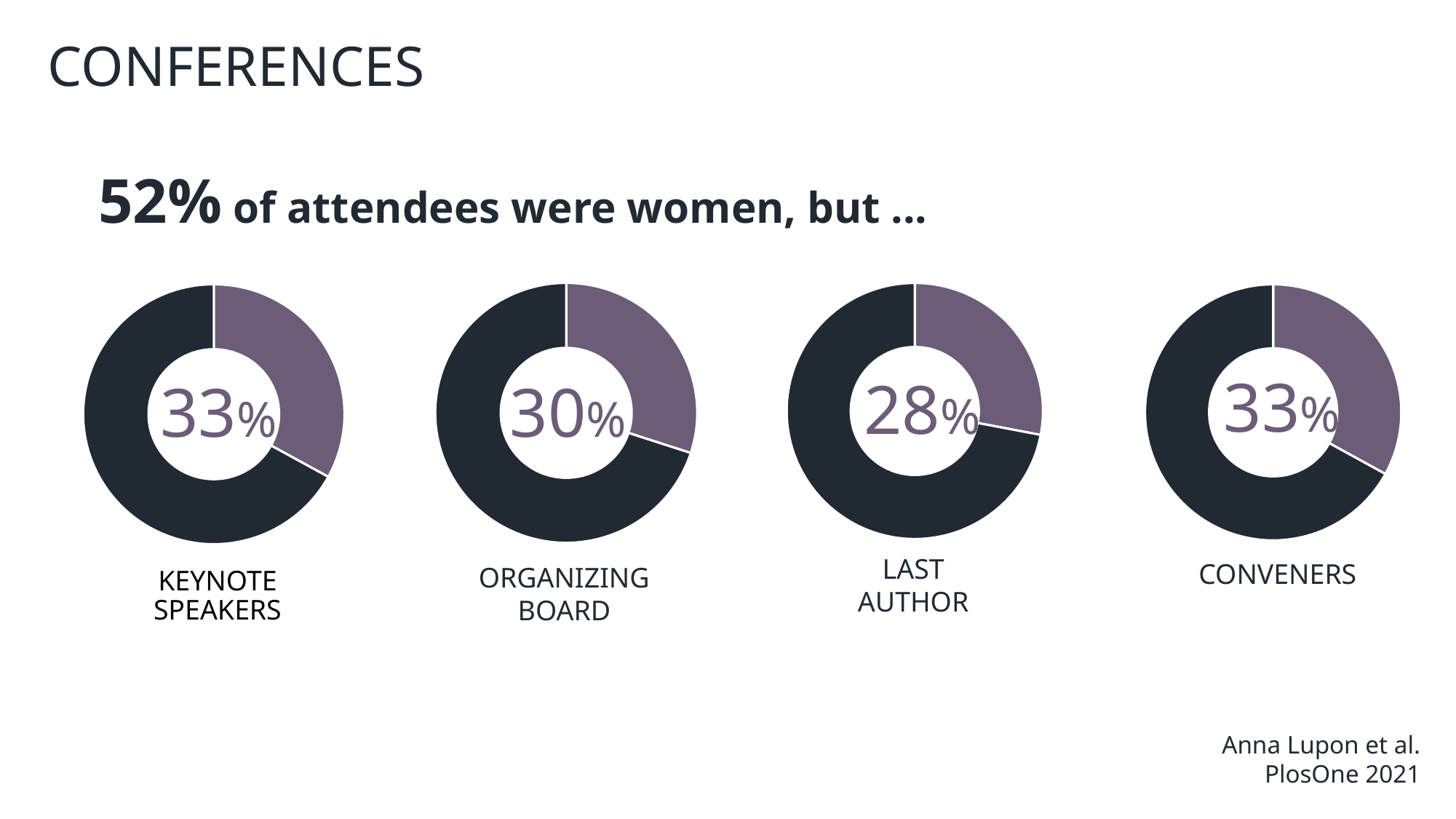
Which is larger, the percentage in the Keynote Speakers chart or the percentage in the Last Author chart? Keynote Speakers What kind of chart is used for the Keynote Speakers figure? Donut (pie) chart What is the difference between the percentage in the Organizing Board chart and the percentage in the Last Author chart? 2% In the Last Author chart, what percentage is shown in the centre? 28% In the Conveners chart, what percentage is shown in the centre? 33% How many donut charts are shown on the slide? 4 In the Last Author chart, what colour is the slice representing the 28% share? Purple Across the four donut charts, which category shows the lowest percentage? Last Author In the Organizing Board chart, what percentage is shown in the centre? 30% Which is larger, the percentage in the Organizing Board chart or the percentage in the Conveners chart? Conveners What is the difference between the percentage in the Keynote Speakers chart and the percentage in the Last Author chart? 5% In the Keynote Speakers chart, what percentage is shown in the centre? 33%